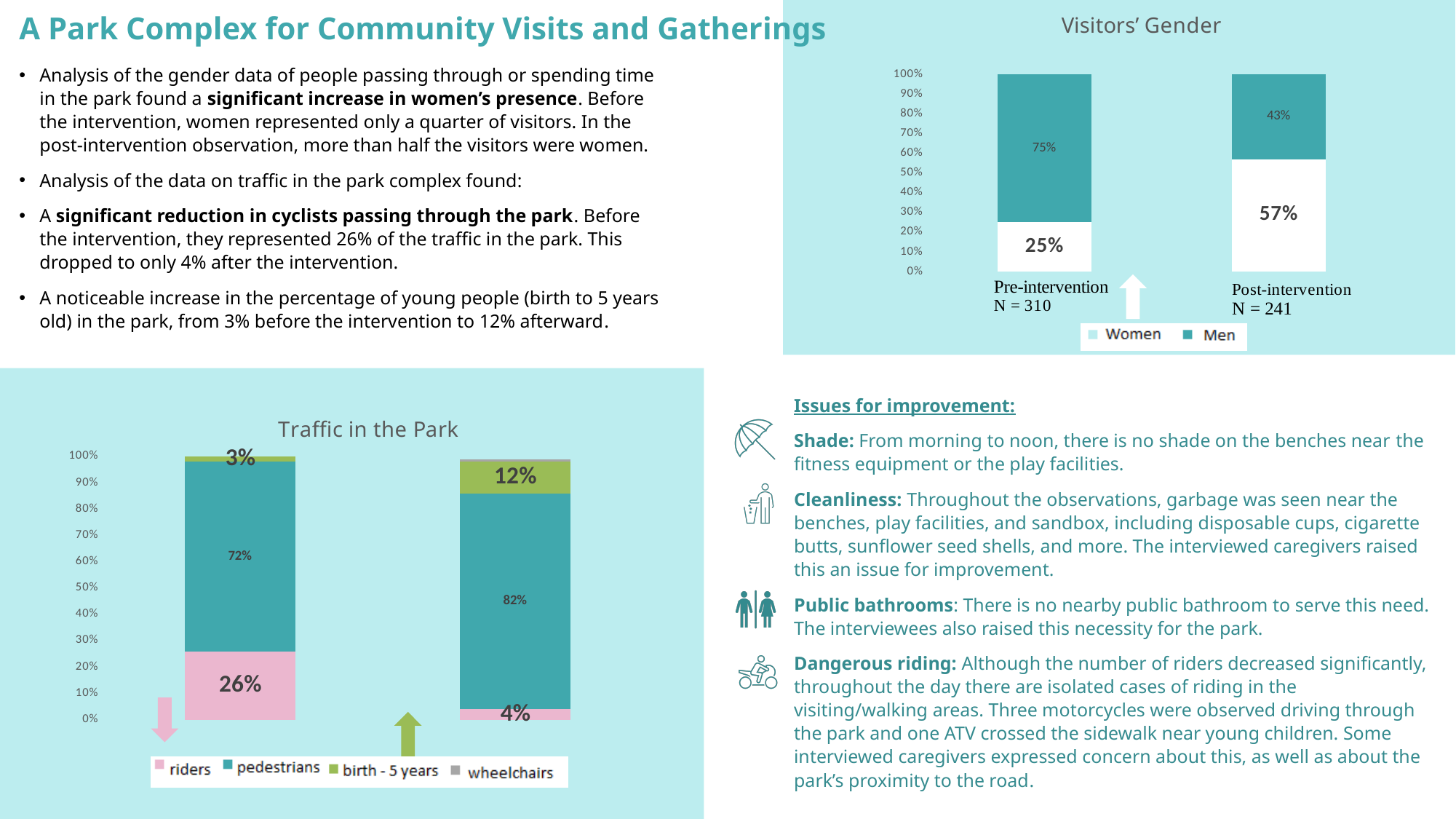
In the Traffic in the Park chart, which segment is the largest in the left bar? pedestrians In the Traffic in the Park chart, what is the difference between the birth - 5 years share in the right bar and in the left bar? 9% In the Visitors' Gender chart, how many series does the legend list? 2 In the Visitors' Gender chart, what percentage of visitors were women pre-intervention? 25% In the Visitors' Gender chart, what is the sample size (N) for the post-intervention bar? 241 What kind of chart is the Traffic in the Park chart? Stacked bar chart In the Visitors' Gender chart, what is the difference between the women's share post-intervention and pre-intervention? 32% In the Visitors' Gender chart, what percentage of visitors were men post-intervention? 43% In the Traffic in the Park chart, how many series does the legend list? 4 In the Traffic in the Park chart, what percentage does the pedestrians segment represent in the right bar? 82% In the Traffic in the Park chart, what percentage does the riders segment represent in the left bar? 26% In the Visitors' Gender chart, which is larger: the men's share pre-intervention or the men's share post-intervention? Pre-intervention